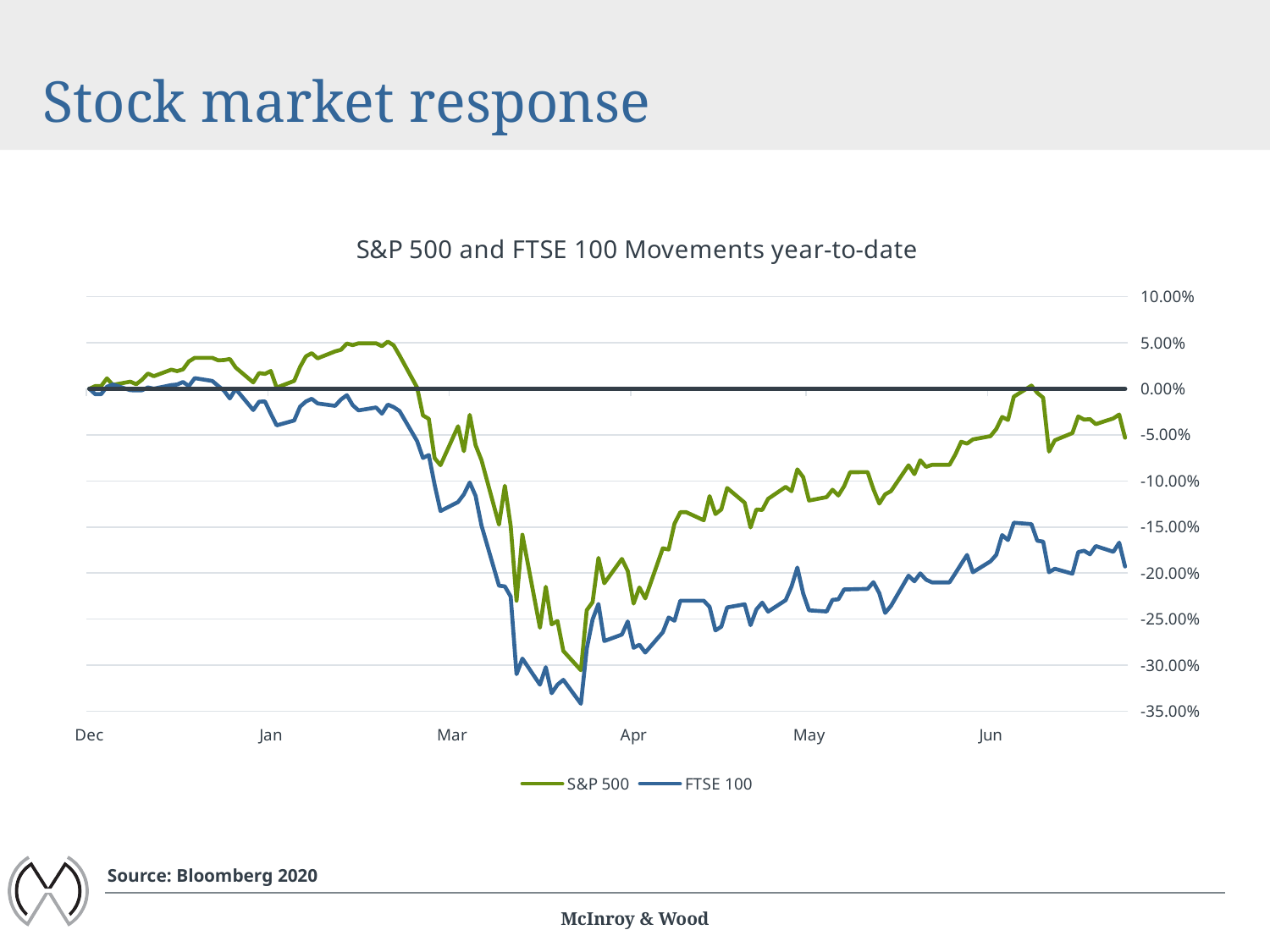
What kind of chart is shown on the slide? Line chart At the Apr label, which series is higher, S&P 500 or FTSE 100? S&P 500 What is the title of the chart? S&P 500 and FTSE 100 Movements year-to-date Is the lowest value of the FTSE 100 line greater or less than -30.00%? less Which series is drawn in blue? FTSE 100 Does the FTSE 100 line rise or fall between the Apr label and the Jun label? rise Which series reaches the lowest point on the chart? FTSE 100 How many month labels are shown on the x axis? 6 How many series does the legend list? 2 Does the S&P 500 line rise or fall between the Mar label and the Apr label? fall Which series is higher at the end of the chart (after Jun)? S&P 500